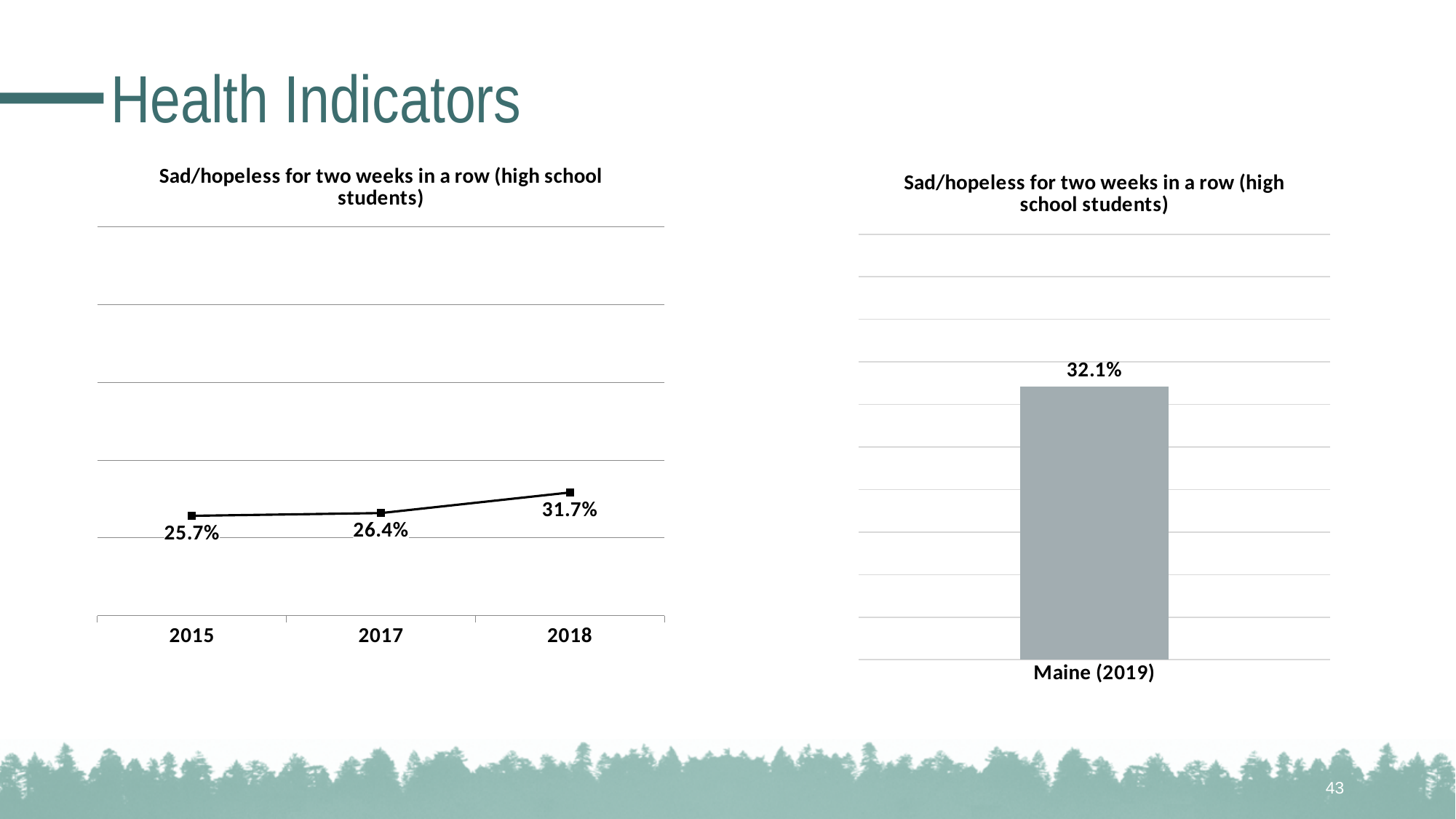
How many data points are plotted in the left chart? 3 In the left chart, what is the difference between the 2018 and 2017 values? 5.3% What kind of chart is the right chart? bar chart In the left chart, what is the difference between the 2018 and 2015 values? 6.0% In the left chart, which year has the lowest value? 2015 In the left chart, what is the value for 2018? 31.7% In the right chart, what is the value for Maine (2019)? 32.1% In the left chart, what is the value for 2017? 26.4% In the left chart, what is the value for 2015? 25.7% In the left chart, do the values rise or fall from 2015 to 2018? rise In the left chart, which year has the highest value? 2018 Which is larger: the 2018 value in the left chart or the Maine (2019) value in the right chart? Maine (2019)